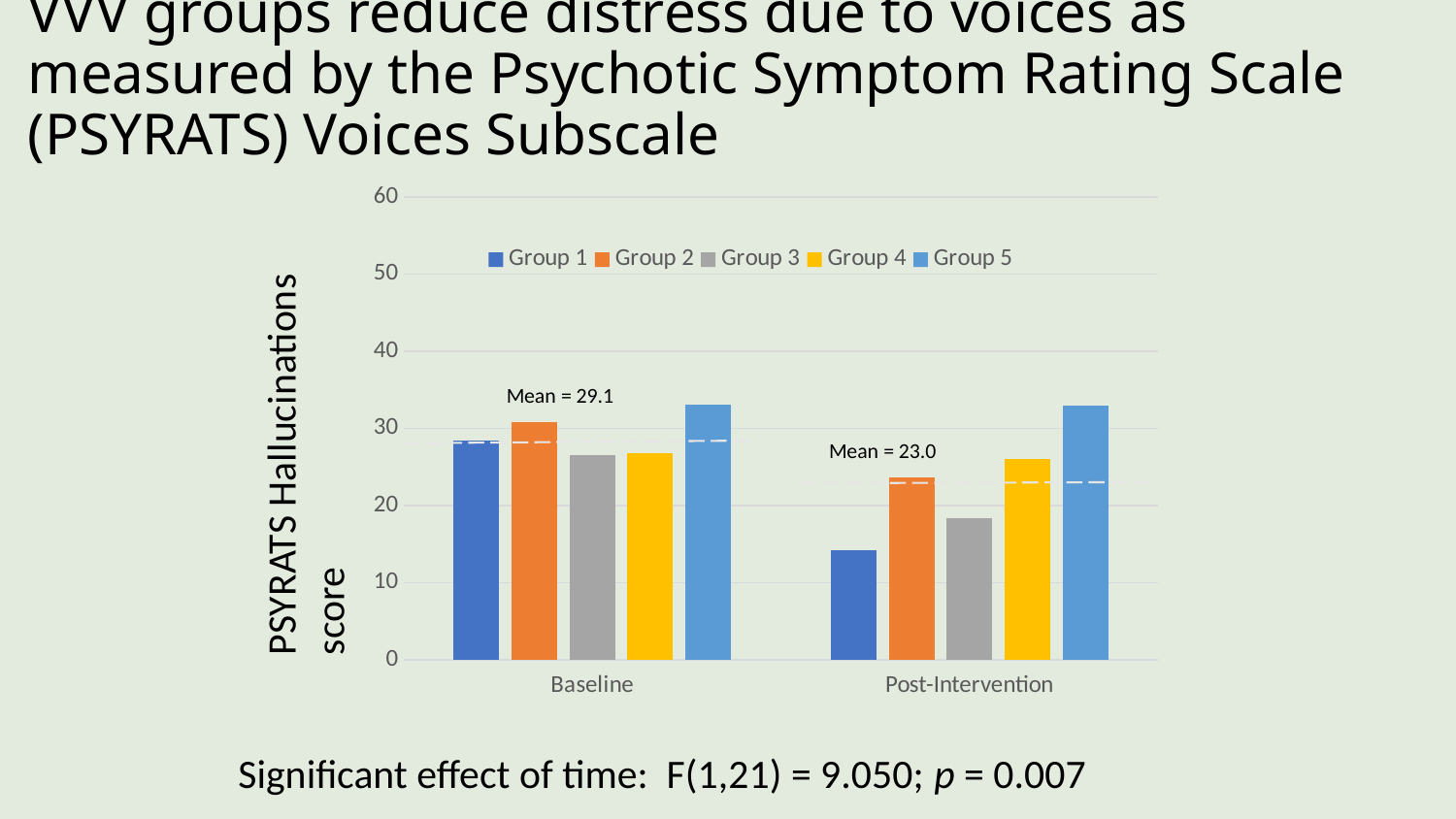
Which group has the lowest score at Post-Intervention? Group 1 What kind of chart is shown on the slide? Bar chart What is the mean PSYRATS Hallucinations score at Baseline, as annotated on the chart? 29.1 Is Group 1's score larger at Baseline or at Post-Intervention? Baseline What is the mean PSYRATS Hallucinations score at Post-Intervention, as annotated on the chart? 23.0 How many series does the legend list? 5 Which group has the highest score at Baseline? Group 5 By how much does the annotated mean score drop from Baseline to Post-Intervention? 6.1 Which group has the highest score at Post-Intervention? Group 5 How many categories are shown on the x axis? 2 Is the Post-Intervention value for Group 1 greater or less than 20? less Is the Baseline value for Group 5 greater or less than 30? greater